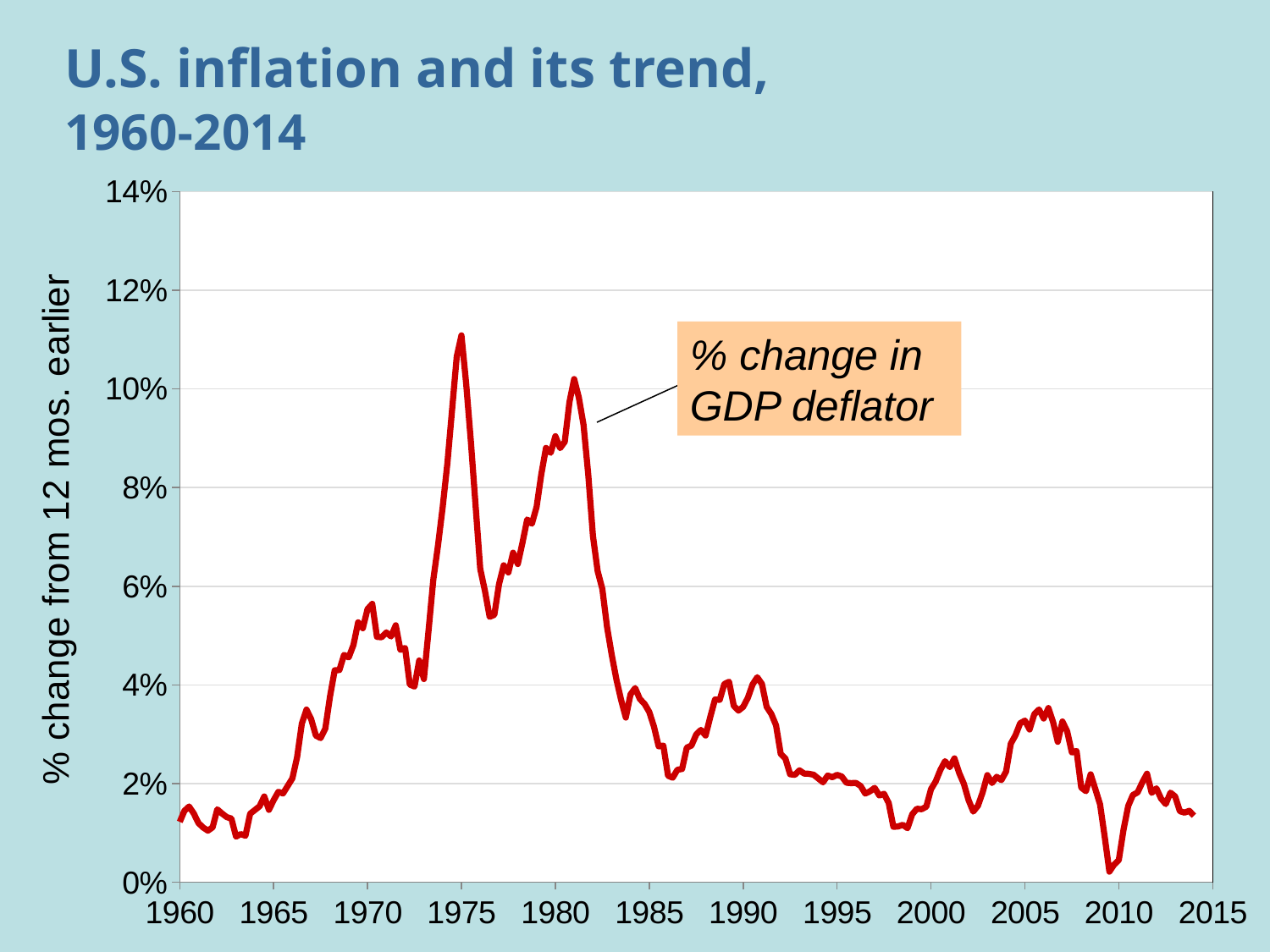
Do the values rise or fall between 1981 and 1986? fall What does the label on the vertical axis say? % change from 12 mos. earlier Around which year does the inflation rate reach its highest peak? 1975 Is the value for 1960 greater or less than 2%? less Which is larger, the value for 1975 or the value for 1990? 1975 Is the value for 1975 greater or less than 10%? greater How many data series are plotted on the chart? 1 What is the title of the chart? U.S. inflation and its trend, 1960-2014 What kind of chart is shown on the slide? line chart Around which year does the inflation rate reach its lowest point? 2010 Is the value for 1990 greater or less than 6%? less